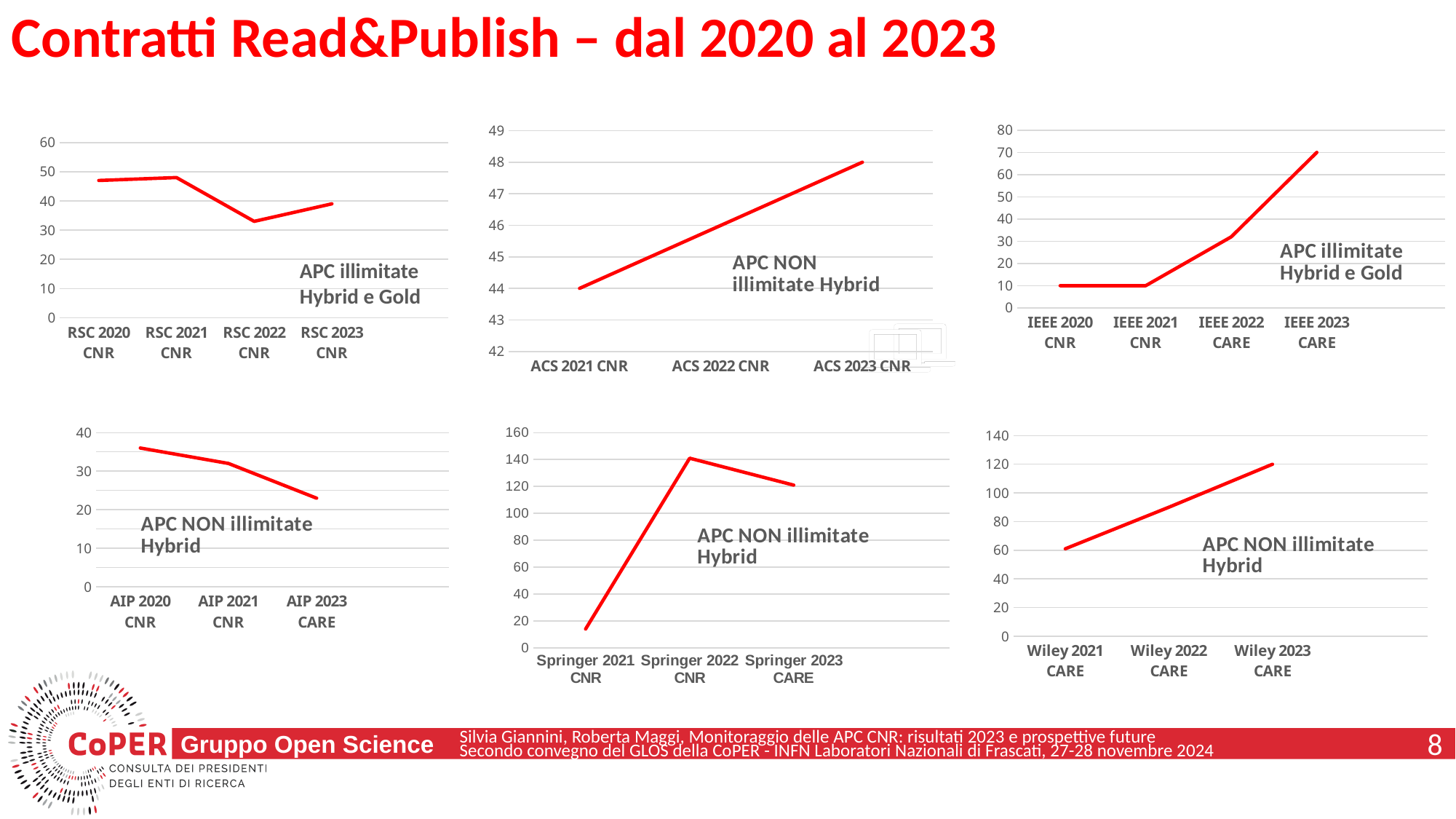
In the ACS chart (top middle), what is the value for ACS 2021 CNR? 44 What kind of chart is the Wiley chart (bottom right)? line chart In the RSC chart (top left), which category has the lowest value? RSC 2022 CNR In the AIP chart (bottom left), do the values rise or fall from AIP 2020 CNR to AIP 2023 CARE? fall How many categories are shown on the x axis of the RSC chart (top left)? 4 In the IEEE chart (top right), what is the value for IEEE 2020 CNR? 10 In the RSC chart (top left), is the value for RSC 2020 CNR greater or less than 40? greater In the ACS chart (top middle), what is the value for ACS 2023 CNR? 48 In the Springer chart (bottom middle), which category has the highest value? Springer 2022 CNR In the IEEE chart (top right), what is the value for IEEE 2023 CARE? 70